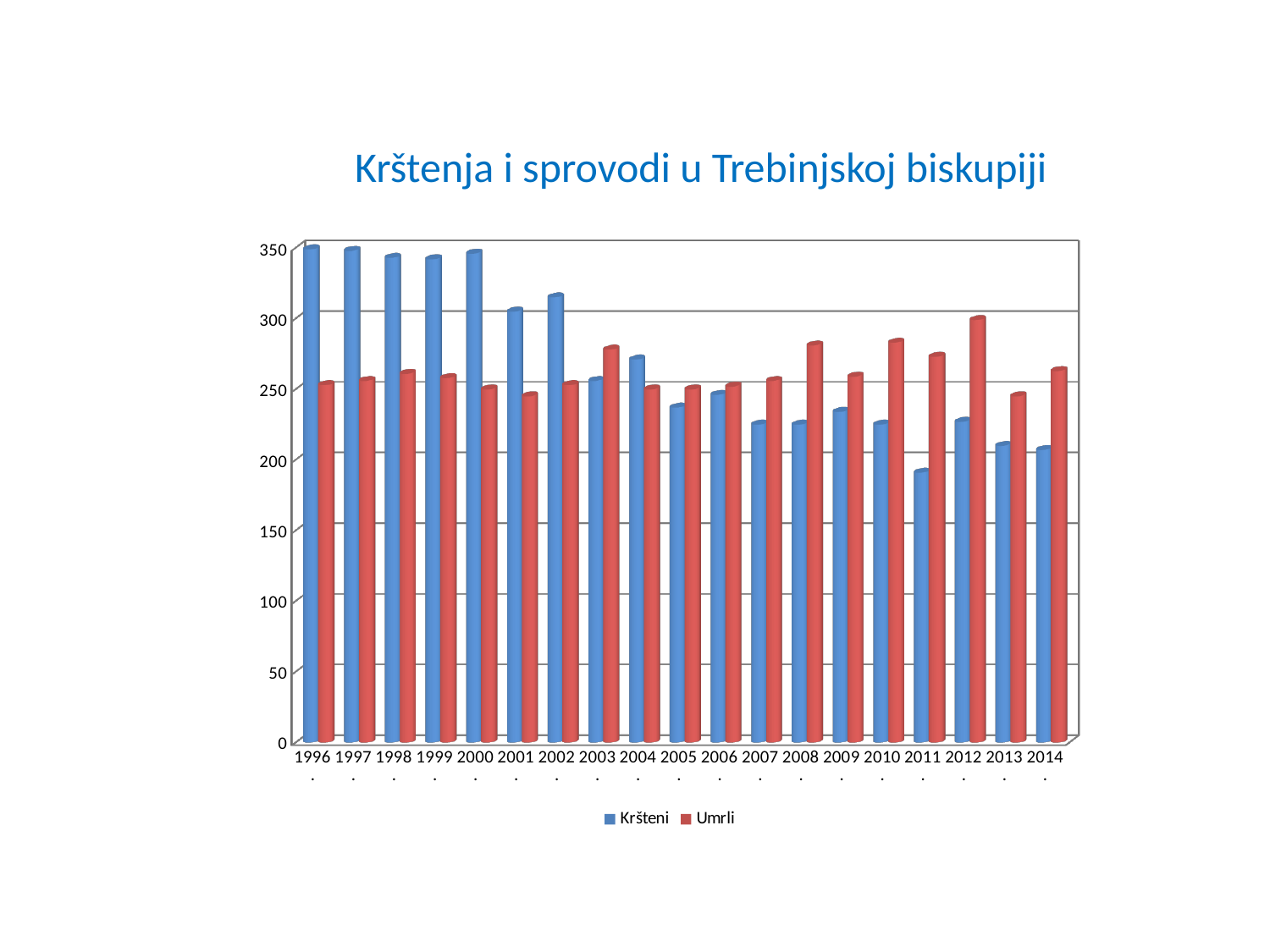
How many years are shown on the x axis? 19 Is the Umrli value for 2008 greater or less than 250? greater What is the title of the chart? Krštenja i sprovodi u Trebinjskoj biskupiji In which year is the Umrli value highest? 2012 Do the Kršteni values generally rise or fall from 1996 to 2014? fall Which series is shown in red? Umrli How many series does the legend list? 2 Is the Kršteni value for 2011 greater or less than 200? less In 1996, which is larger, Kršteni or Umrli? Kršteni In which year is the Kršteni value lowest? 2011 What kind of chart is shown on the slide? bar chart